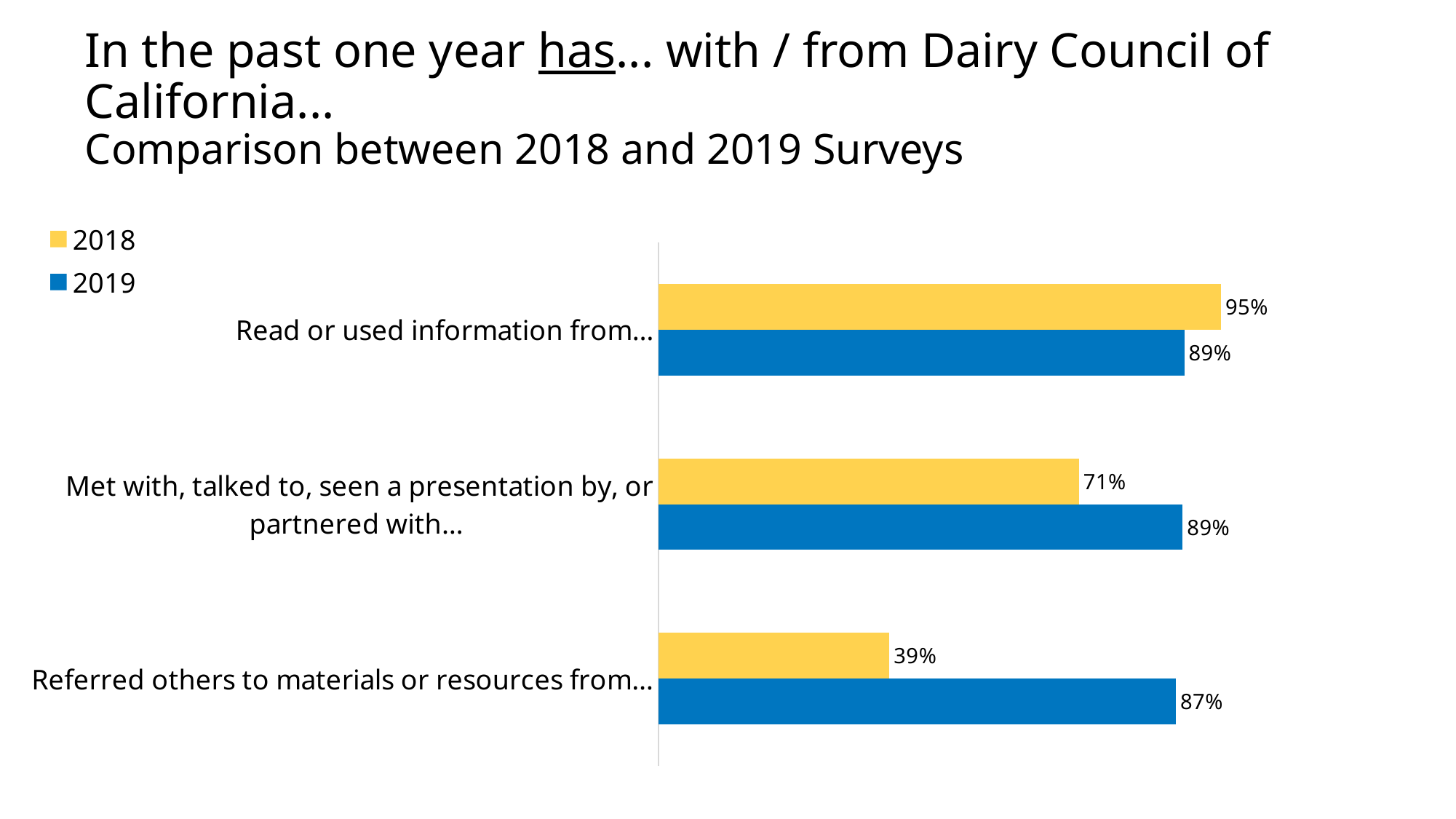
How many categories are shown in the chart? 3 What kind of chart is shown on the slide? Bar chart What is the difference between the 2019 and 2018 values for "Referred others to materials or resources from..."? 48% What is the 2019 value for "Met with, talked to, seen a presentation by, or partnered with..."? 89% For "Met with, talked to, seen a presentation by, or partnered with...", which year has the larger value, 2018 or 2019? 2019 What is the 2018 value for "Read or used information from..."? 95% Which category has the highest 2018 value? Read or used information from... What is the difference between the 2018 and 2019 values for "Read or used information from..."? 6% Which category has the lowest 2018 value? Referred others to materials or resources from... What is the 2018 value for "Met with, talked to, seen a presentation by, or partnered with..."? 71% What is the 2019 value for "Referred others to materials or resources from..."? 87% How many series does the legend list? 2